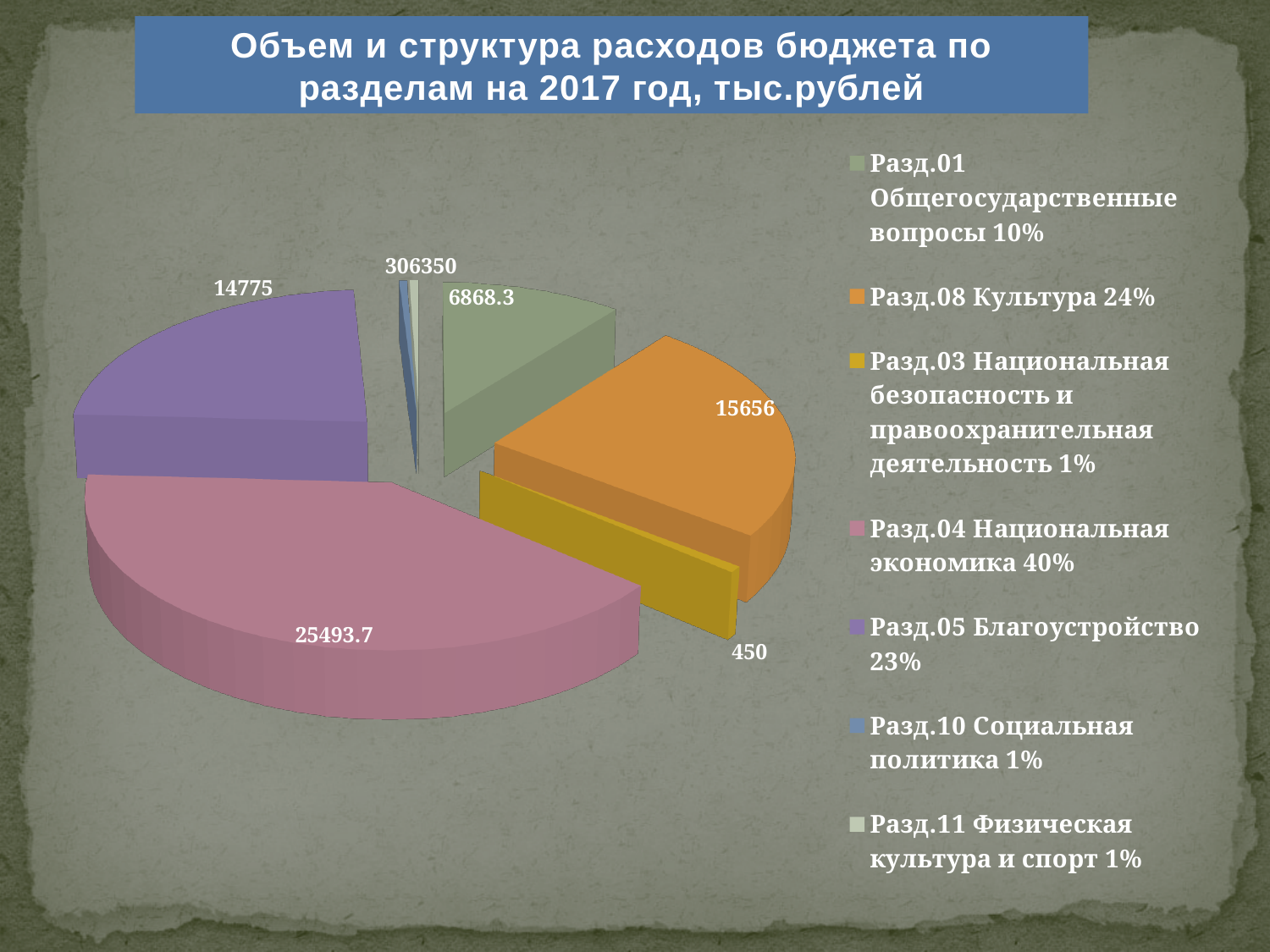
How many sections does the legend list? 7 What is the value for Разд.01 Общегосударственные вопросы? 6868.3 What kind of chart is shown on the slide? pie chart What share of the pie does Разд.05 Благоустройство represent? 23% What is the value for Разд.05 Благоустройство? 14775 Which is larger, the value for Разд.08 Культура or the value for Разд.05 Благоустройство? Разд.08 Культура What share of the pie does Разд.08 Культура represent? 24% What is the difference between the values for Разд.04 Национальная экономика and Разд.05 Благоустройство? 10718.7 What is the value for Разд.04 Национальная экономика? 25493.7 What is the value for Разд.08 Культура? 15656 Which section has the largest slice of the pie? Разд.04 Национальная экономика What is the value for Разд.03 Национальная безопасность и правоохранительная деятельность? 450